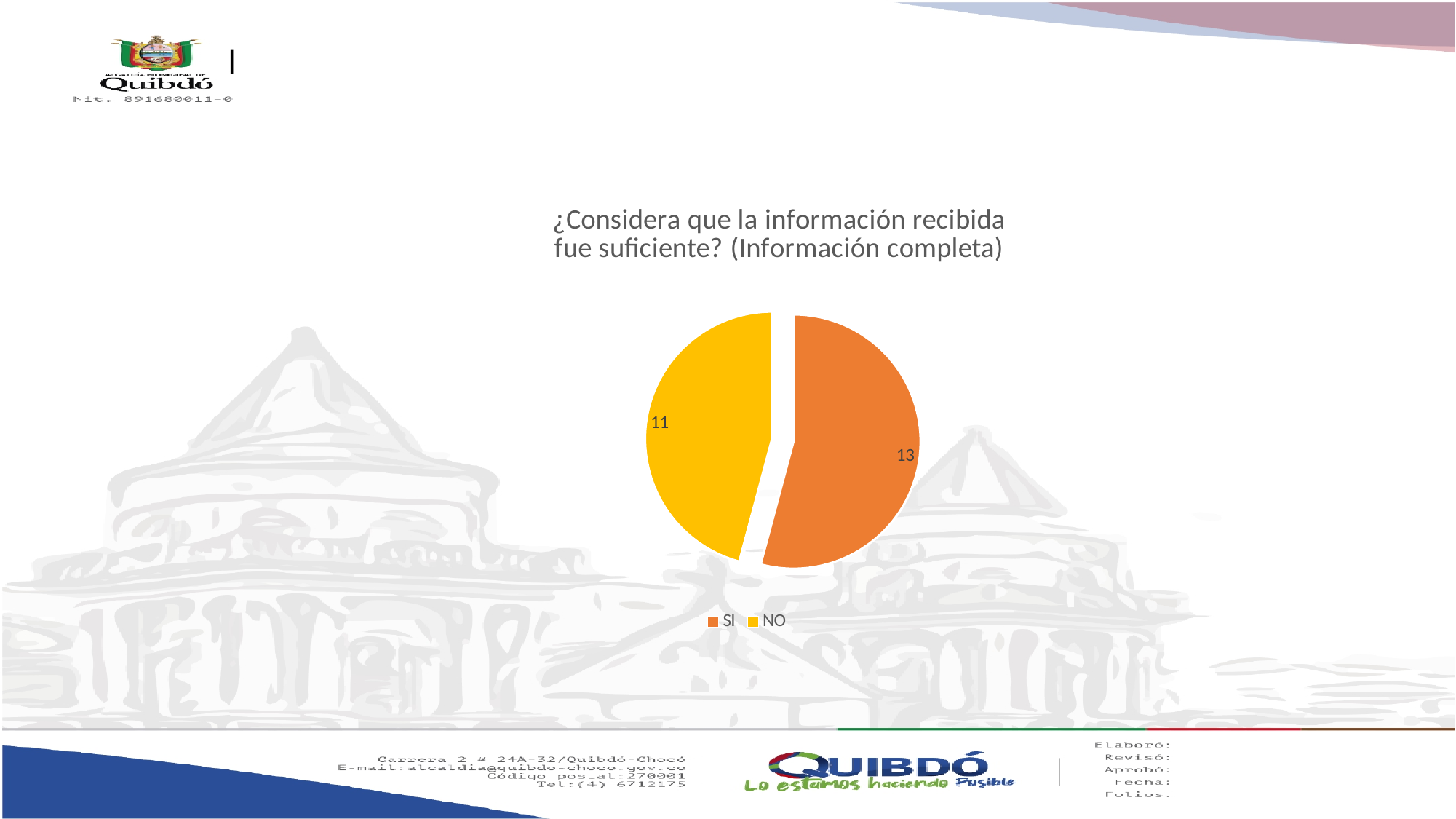
What colour is the SI slice? orange What is the difference between the values for SI and NO? 2 What is the total of all slices in the pie chart? 24 What is the value for SI? 13 Which category has the smallest slice? NO What is the title of the chart? ¿Considera que la información recibida fue suficiente? (Información completa) How many categories does the pie chart have? 2 Which category has the largest slice? SI How many entries does the legend list? 2 What is the value for NO? 11 Which is larger, the value for SI or the value for NO? SI What type of chart is shown on the slide? pie chart